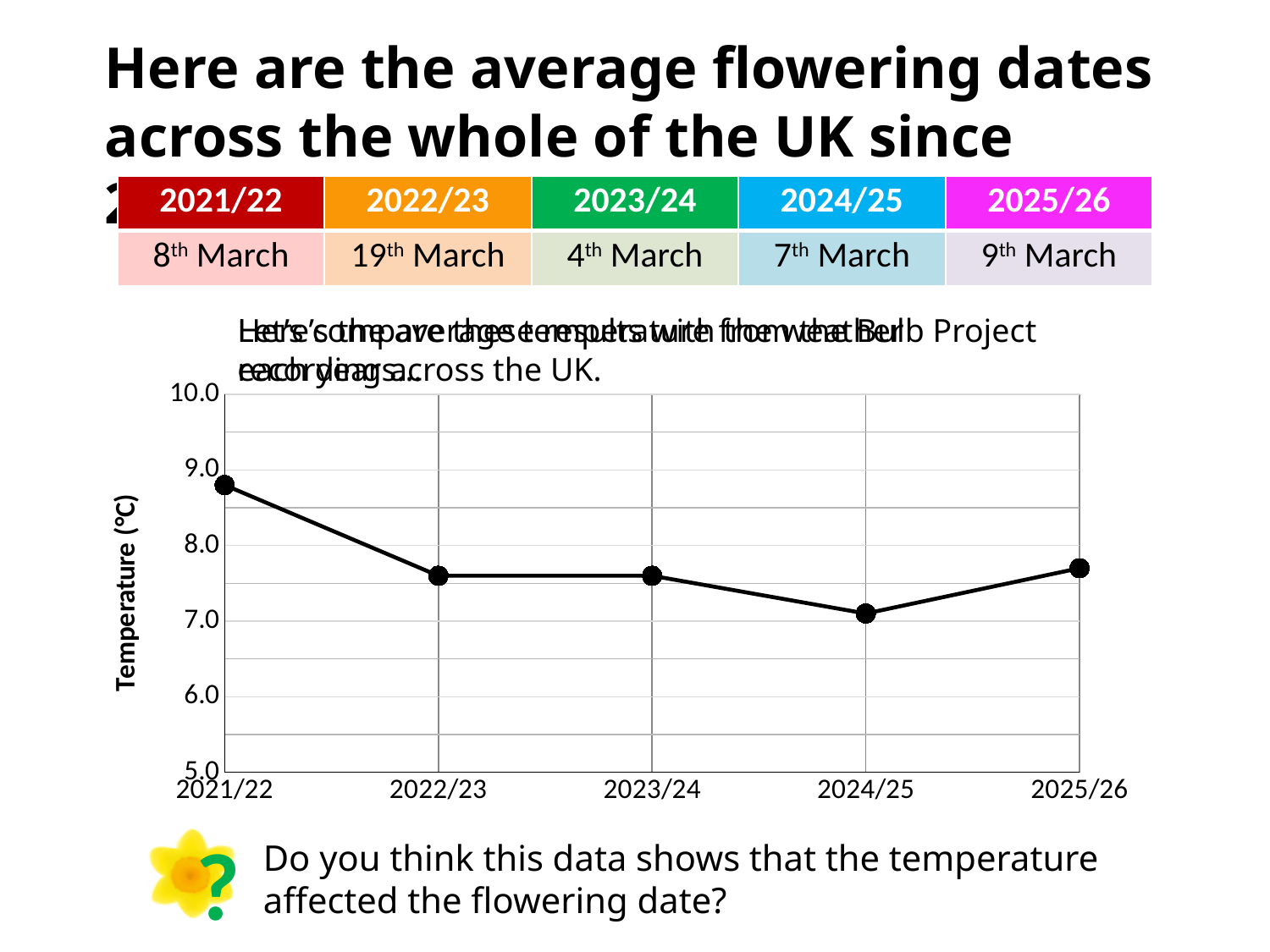
Which year has the highest temperature on the line chart? 2021/22 Which year has the lowest temperature on the line chart? 2024/25 Which has the higher temperature, 2021/22 or 2024/25? 2021/22 Which has the lower temperature, 2024/25 or 2025/26? 2024/25 What kind of chart is shown on the slide? line chart Does the temperature rise or fall from 2021/22 to 2024/25? fall Is the temperature for 2023/24 greater or less than 9.0? less Is the temperature for 2022/23 greater or less than 8.0? less Is the temperature for 2025/26 greater or less than 7.0? greater How many data points are plotted on the line chart? 5 What is the label on the vertical axis of the chart? Temperature (°C)